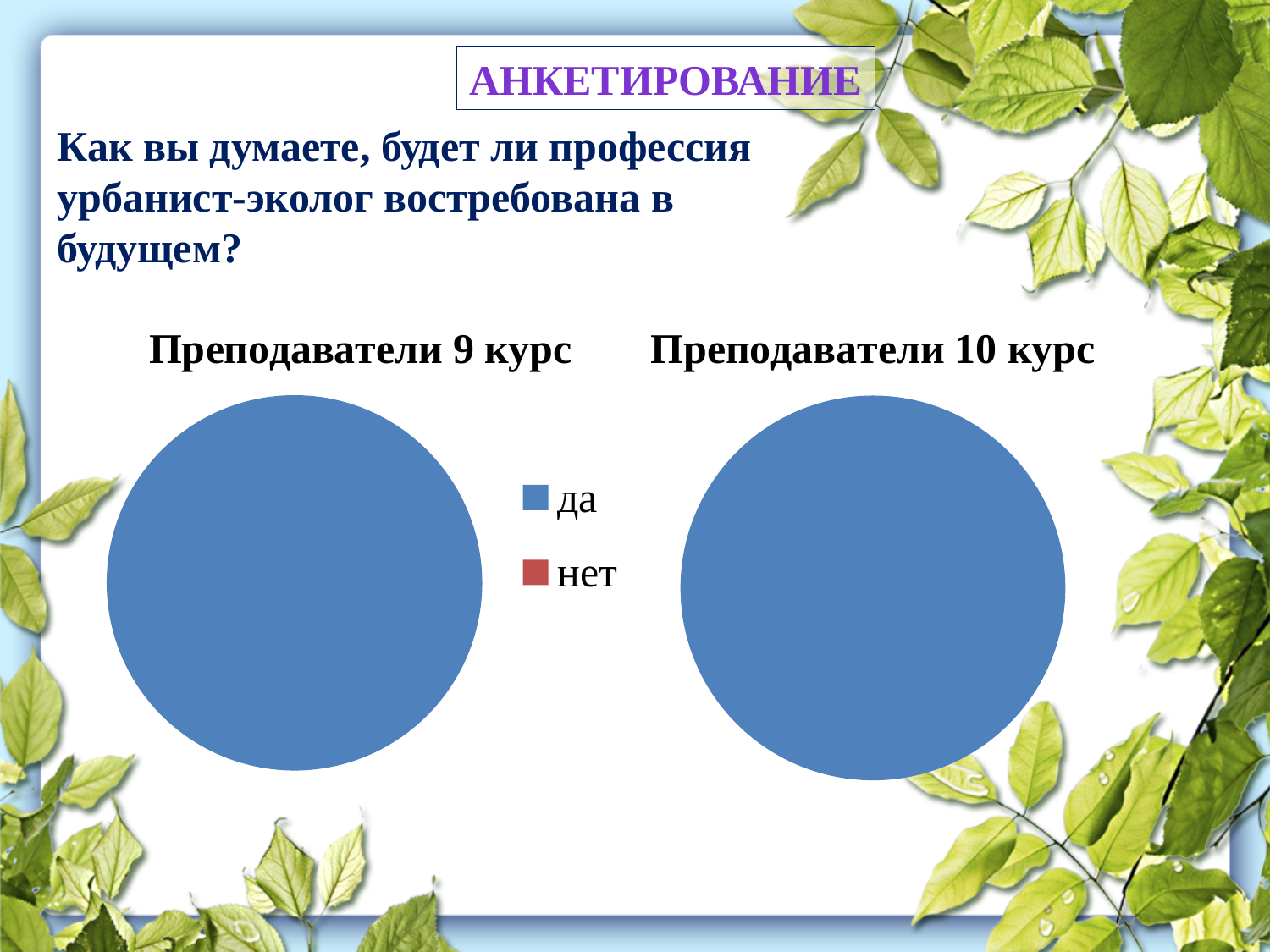
In the chart titled "Преподаватели 9 курс", which answer has the smallest share of the pie? нет What kind of chart is the chart titled "Преподаватели 10 курс"? pie chart What kind of chart is the chart titled "Преподаватели 9 курс"? pie chart In the chart titled "Преподаватели 10 курс", what share of the pie does "да" take? 100% In the chart titled "Преподаватели 10 курс", which answer has the largest share of the pie? да What colour represents "нет" in the legend? red In the chart titled "Преподаватели 9 курс", which answer has the largest share of the pie? да In the chart titled "Преподаватели 10 курс", which answer has the smallest share of the pie? нет How many visible slices does the chart titled "Преподаватели 9 курс" have? 1 What is the title of the pie chart on the right side of the slide? Преподаватели 10 курс How many entries does the legend shared by the two pie charts list? 2 In the chart titled "Преподаватели 9 курс", is the share for "да" larger or smaller than the share for "нет"? larger